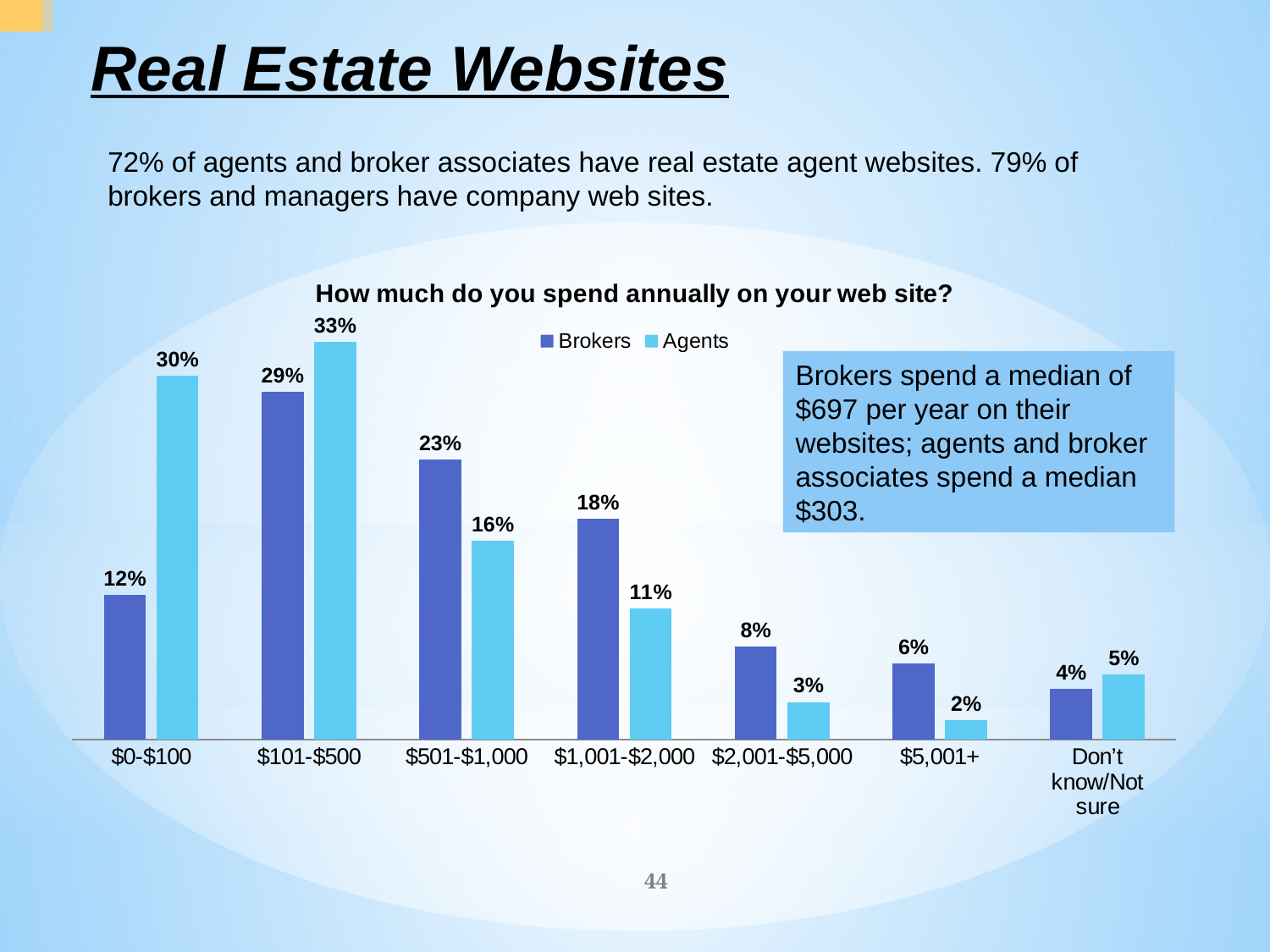
What kind of chart is shown on the slide? Bar chart Which spending category has the lowest value for Agents? $5,001+ In the $5,001+ category, which series has the larger value, Brokers or Agents? Brokers Which spending category has the highest value for Brokers? $101-$500 How many series does the legend list? 2 In the $0-$100 category, which series has the larger value, Brokers or Agents? Agents What is the value for Agents in the $2,001-$5,000 category? 3% What percentage of Brokers spend $501-$1,000 annually on their web site? 23% How many spending categories are shown on the x axis? 7 What is the difference between the Brokers and Agents values in the $1,001-$2,000 category? 7% What is the title of the chart? How much do you spend annually on your web site? What percentage of Agents spend $0-$100 annually on their web site? 30%